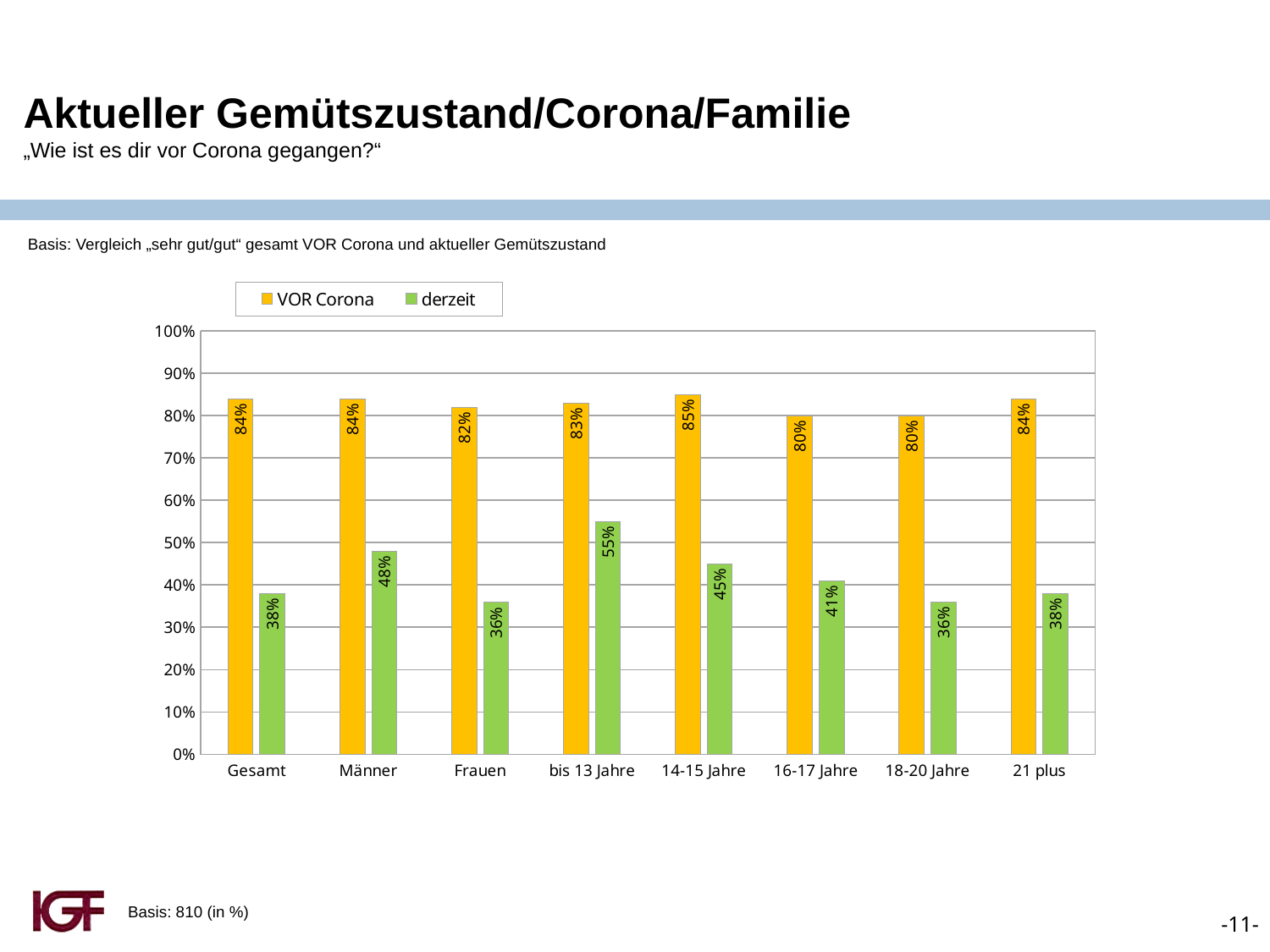
What kind of chart is shown on the slide? bar chart Which category has the highest 'VOR Corona' value? 14-15 Jahre What is the 'VOR Corona' value for Gesamt? 84% How many categories are shown on the x axis? 8 How many series does the legend list? 2 Which series is shown in green in the legend? derzeit Which is larger for 16-17 Jahre: the 'VOR Corona' value or the 'derzeit' value? VOR Corona Which category has the highest 'derzeit' value? bis 13 Jahre What is the difference between the 'VOR Corona' and 'derzeit' values for Frauen? 46% What is the 'derzeit' value for 18-20 Jahre? 36% What is the 'derzeit' value for bis 13 Jahre? 55% What is the 'derzeit' value for Männer? 48%